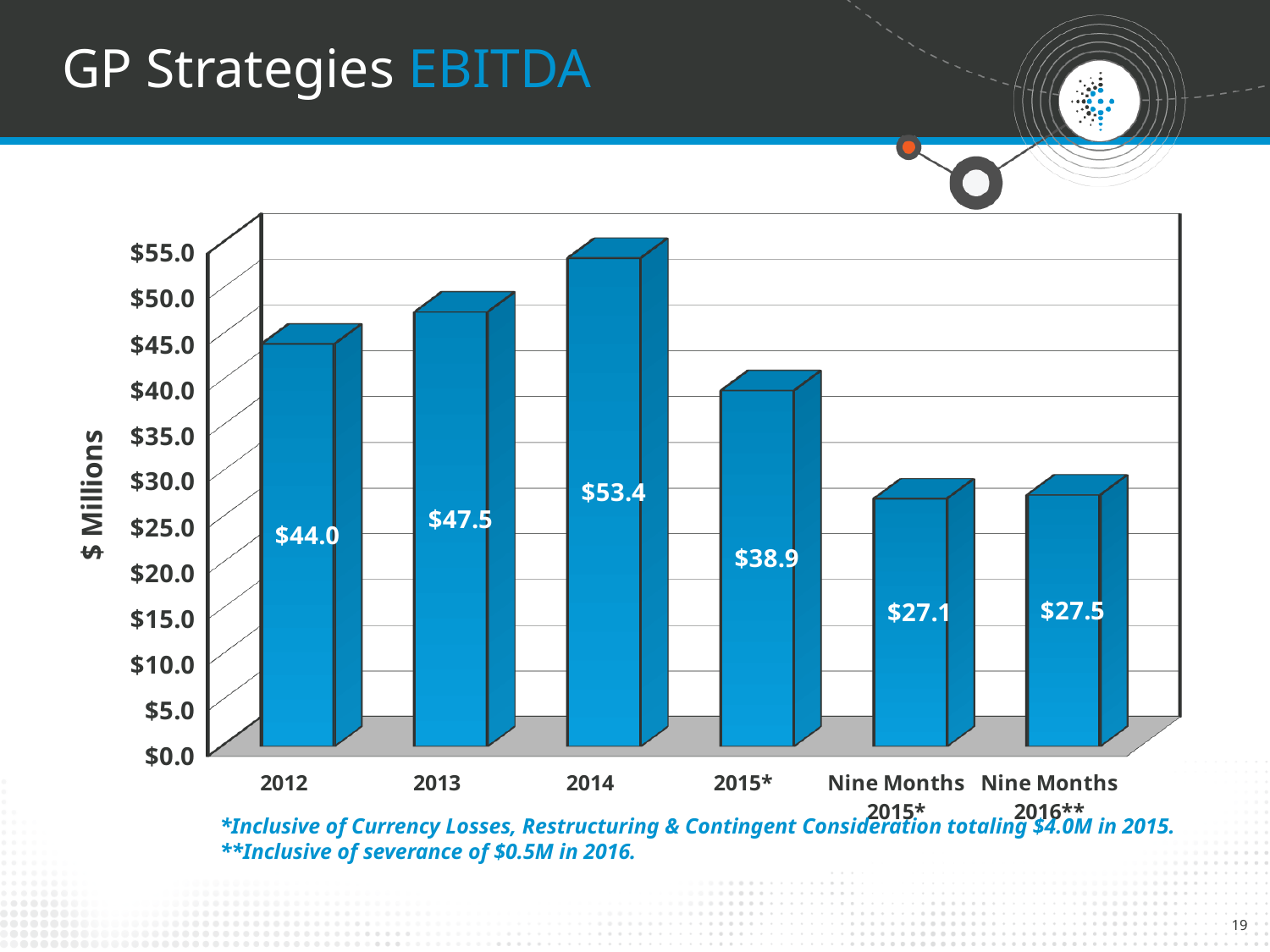
Which category has the highest EBITDA? 2014 How many categories are shown on the x axis? 6 What is the label on the vertical axis of the chart? $ Millions Which category has the lowest EBITDA? Nine Months 2015* Which is larger, the EBITDA for 2013 or for 2015*? 2013 Do the EBITDA values rise or fall from 2012 to 2014? rise What is the EBITDA value for 2014? $53.4 What kind of chart is shown on the slide? bar chart Is the value for 2015* greater or less than $40.0? less What is the EBITDA value for 2012? $44.0 What is the EBITDA value for Nine Months 2016**? $27.5 What is the difference between the EBITDA for 2014 and 2015*? $14.5